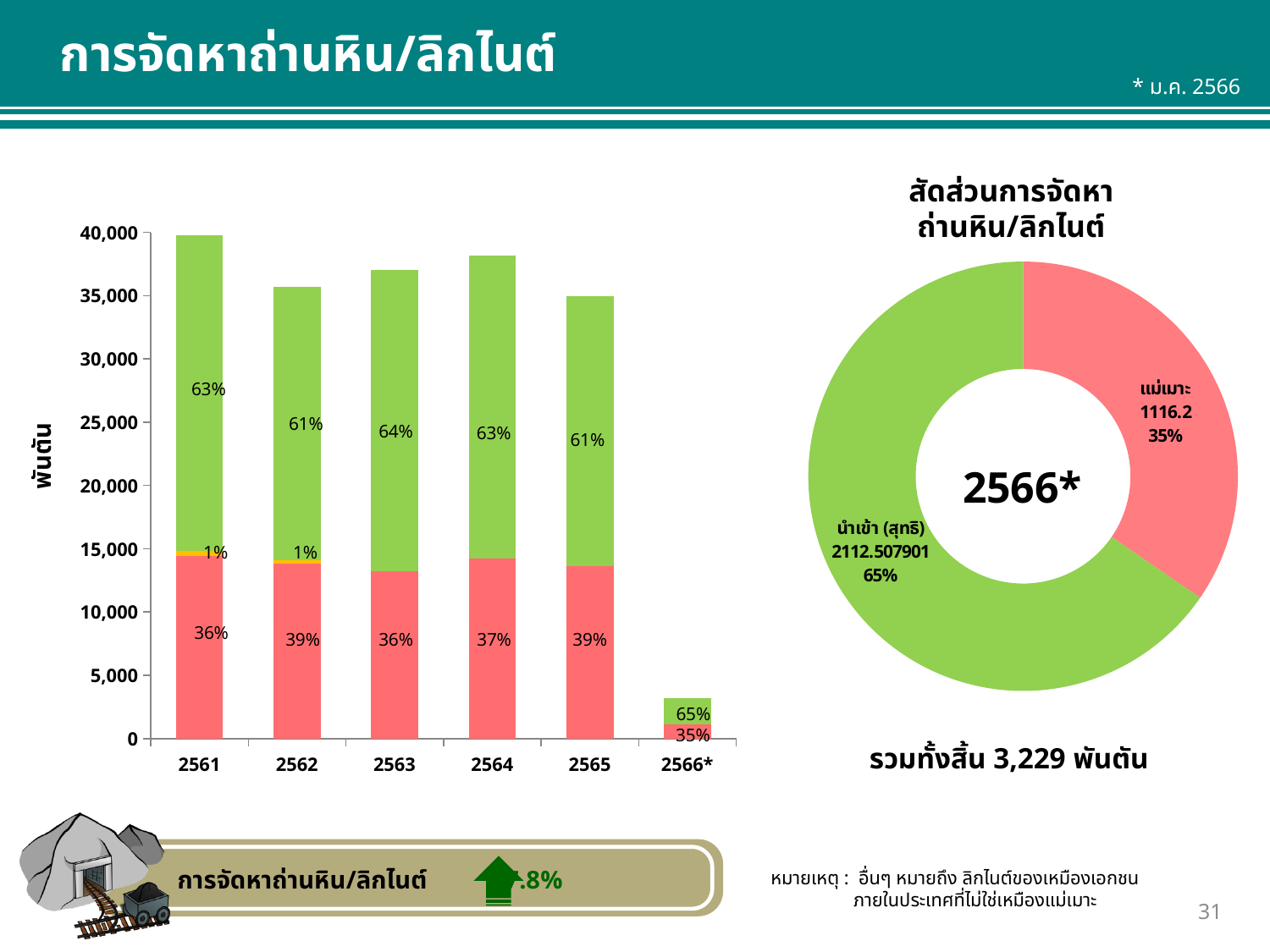
In the bar chart on the left, what percentage label is shown on the yellow segment of the 2561 bar? 1% In the bar chart on the left, is the total value for 2561 greater or less than 35,000? greater In the donut chart titled สัดส่วนการจัดหาถ่านหิน/ลิกไนต์, what value is shown for นำเข้า (สุทธิ)? 2112.507901 What is the axis title on the y axis of the bar chart on the left? พันตัน In the bar chart on the left, what percentage label is shown on the red segment of the 2565 bar? 39% In the bar chart on the left, which year has the shortest total bar? 2566* How many years are shown on the x axis of the bar chart on the left? 6 In the bar chart on the left, what percentage label is shown on the green segment of the 2563 bar? 64% In the bar chart on the left, is the total value for 2566* greater or less than 5,000? less In the donut chart titled สัดส่วนการจัดหาถ่านหิน/ลิกไนต์, what share does แม่เมาะ have? 35% What kind of chart is the chart on the left of the slide? Stacked bar chart In the bar chart on the left, which year has the tallest total bar? 2561